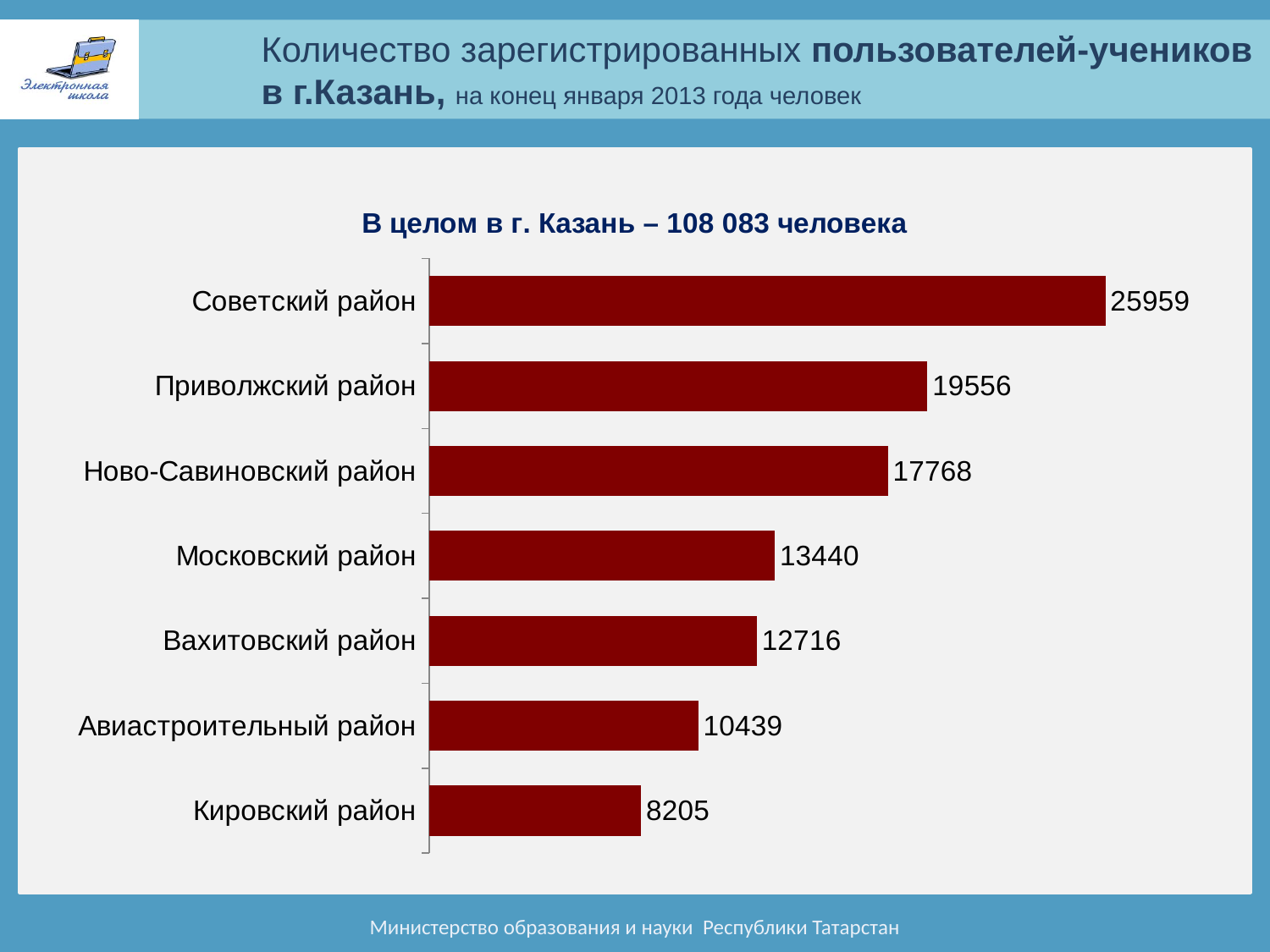
What is the value for Московский район? 13440 What colour are the bars in the chart? dark red What is the difference between the values for Московский район and Вахитовский район? 724 Which is larger, the value for Ново-Савиновский район or the value for Авиастроительный район? Ново-Савиновский район Which district has the highest number of registered student users? Советский район Which district has the lowest number of registered student users? Кировский район What kind of chart is shown on the slide? bar chart What is the value for Кировский район? 8205 What total number of people for Kazan as a whole is stated above the chart? 108 083 What is the value for Советский район? 25959 How many districts are shown in the chart? 7 What is the difference between the values for Советский район and Приволжский район? 6403